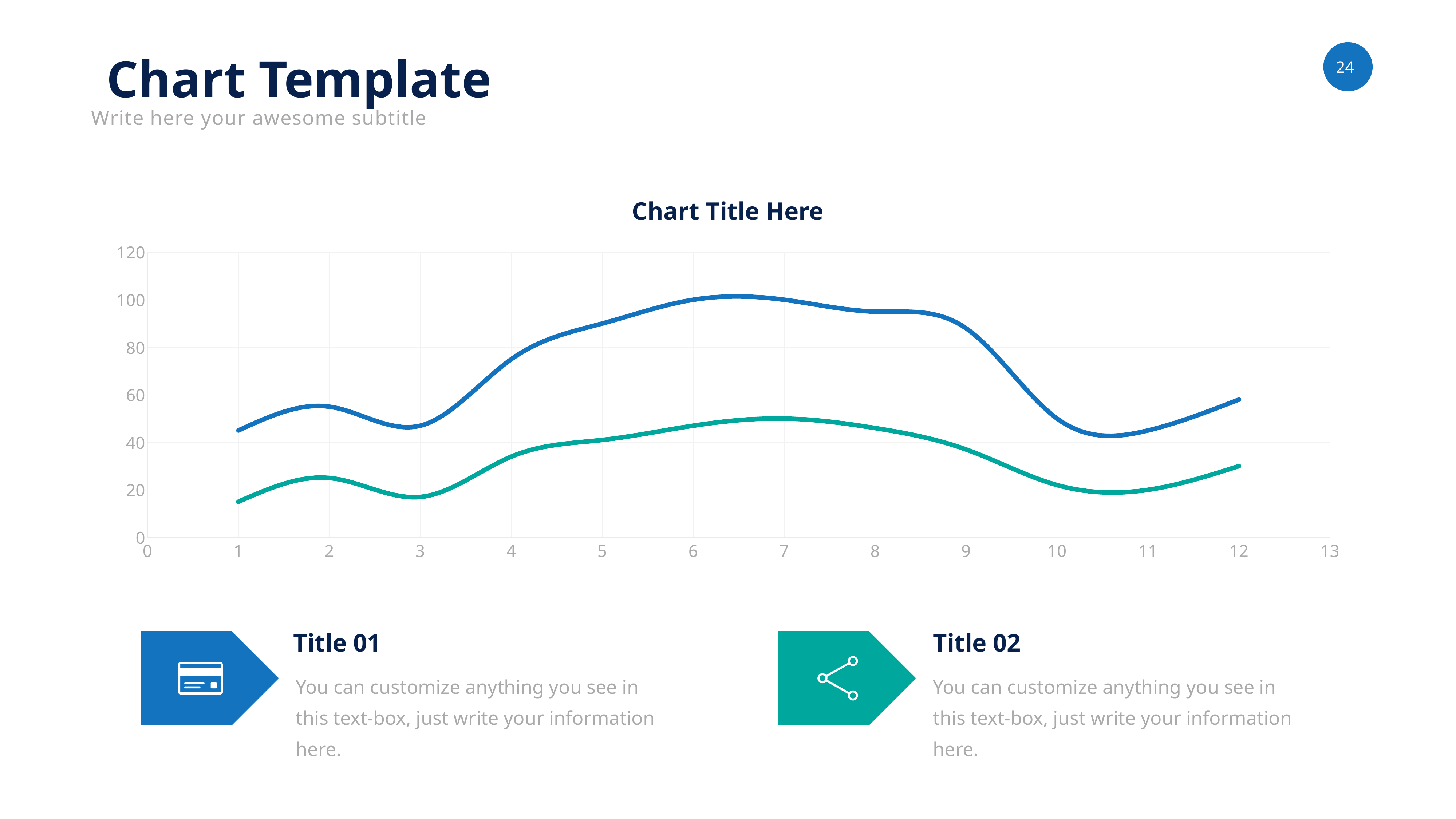
Is the value of the teal line at x = 1 greater or less than 20? less At x = 6, which line has the larger value, the blue line or the teal line? the blue line Does the blue line rise or fall between x = 3 and x = 6? rise What is the highest value shown on the y axis? 120 What is the title of the chart? Chart Title Here Is the value of the blue line at x = 11 greater or less than 60? less How many lines are plotted on the chart? 2 Is the value of the blue line at x = 6 greater or less than 80? greater What kind of chart is shown on the slide? line chart Does the blue line rise or fall between x = 9 and x = 11? fall